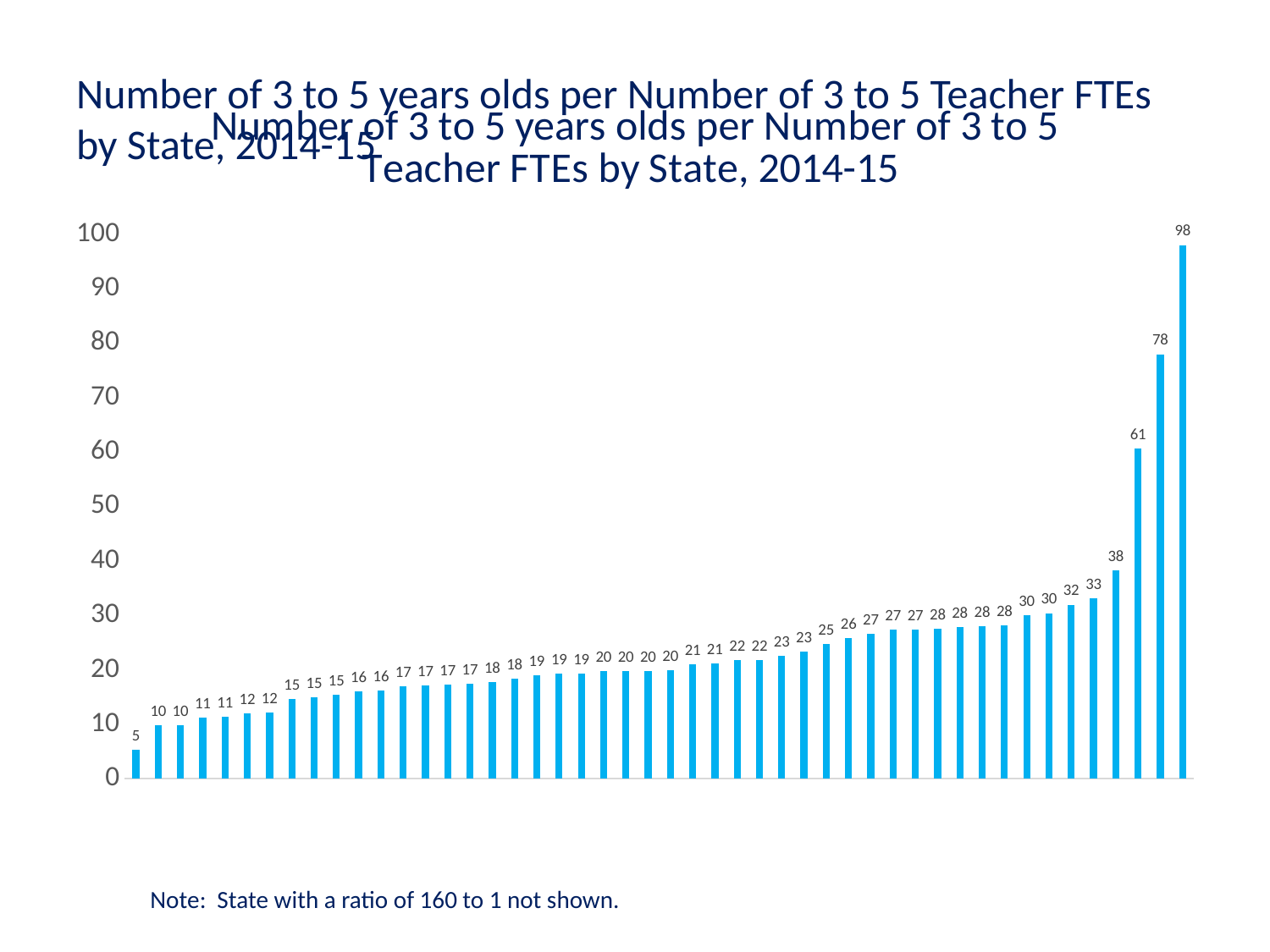
Is the value of the tallest bar greater or less than 90? greater Do the values rise or fall from left to right along the x axis? Rise What kind of chart is shown on the slide? Bar chart What is the title of the chart? Number of 3 to 5 years olds per Number of 3 to 5 Teacher FTEs by State, 2014-15 What is the difference between the highest and lowest values on the chart? 93 Is the value of the shortest bar greater or less than 10? less What is the difference between the two tallest bars on the chart? 20 What is the highest value shown on the chart? 98 What is the value of the third-tallest bar on the chart? 61 According to the note below the chart, what ratio does the state not shown have? 160 to 1 What is the value of the second-tallest bar on the chart? 78 What is the lowest value shown on the chart? 5